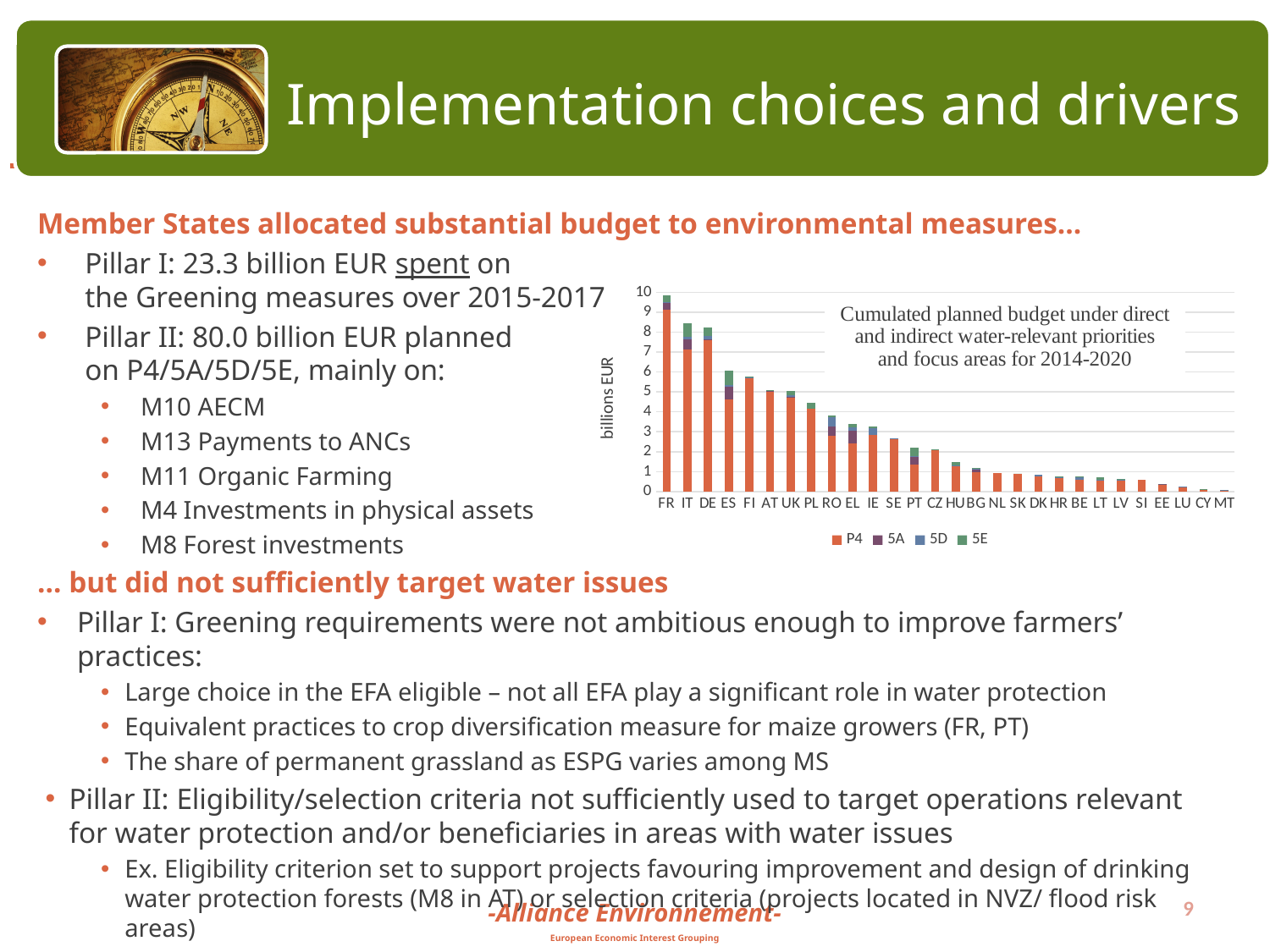
What is the label on the vertical axis of the chart? billions EUR How many Member States (categories) are shown on the x axis of the chart? 28 Which has the larger cumulated planned budget, PL or RO? PL Is the value for SE greater or less than 3 billion EUR? less How many series does the chart legend list? 4 What kind of chart is shown on the slide? Stacked bar chart Is the value for RO greater or less than 4 billion EUR? less Is the value for IT greater or less than 7 billion EUR? greater Which Member State has the highest cumulated planned budget in the chart? FR Do the bar values rise or fall moving from left to right along the x axis? Fall